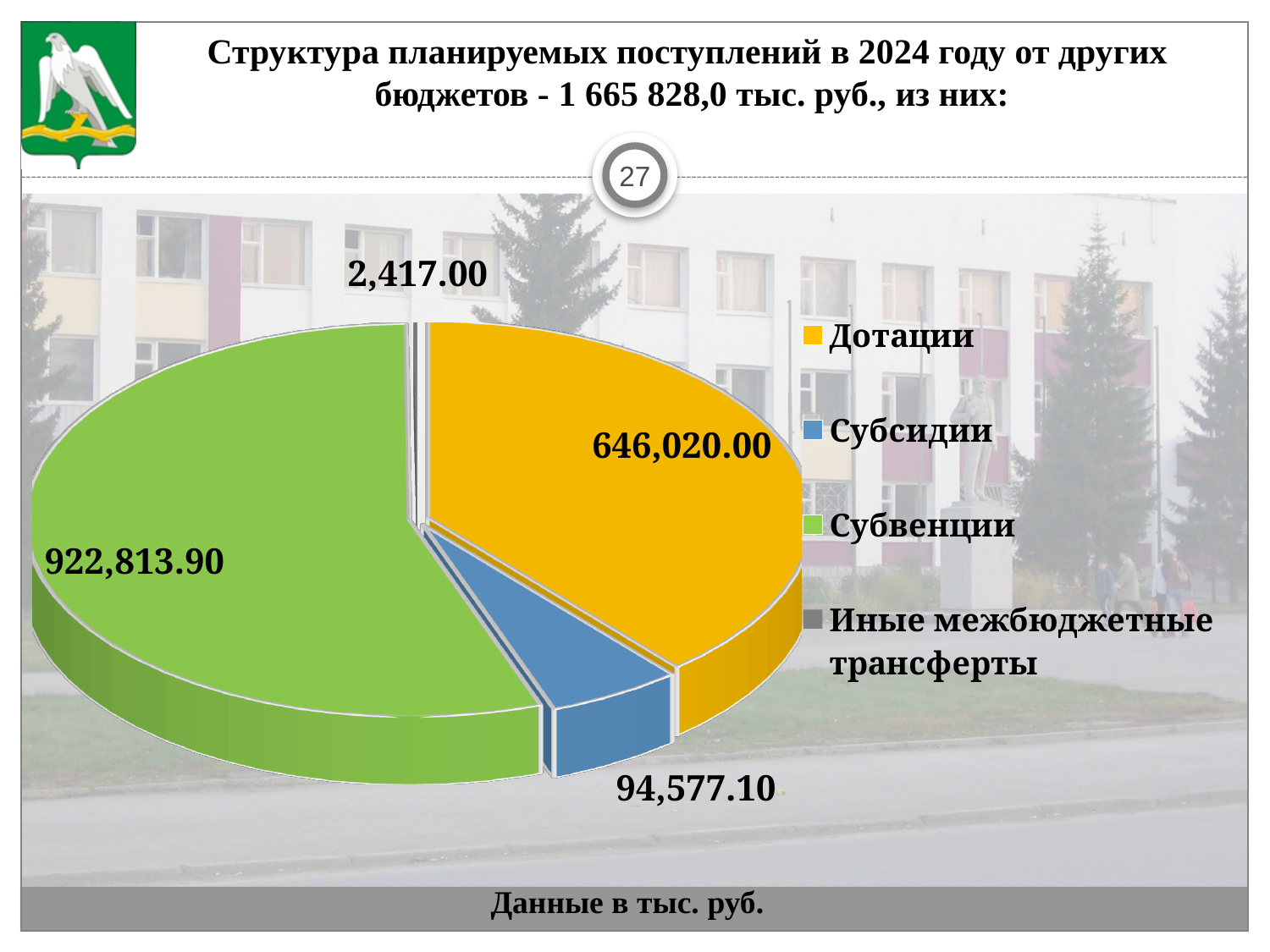
What is the difference between the values for Субвенции and Дотации? 276,793.90 How many categories does the pie chart show? 4 Which category has the largest slice of the pie? Субвенции What is the value for Субсидии? 94,577.10 Which is larger, Субсидии or Дотации? Дотации What type of chart is shown on the slide? Pie chart What is the value for Иные межбюджетные трансферты? 2,417.00 What is the value for Дотации? 646,020.00 What is the difference between the values for Дотации and Субсидии? 551,442.90 What colour is the Субвенции slice? Green What is the value for Субвенции? 922,813.90 Which category has the smallest slice of the pie? Иные межбюджетные трансферты